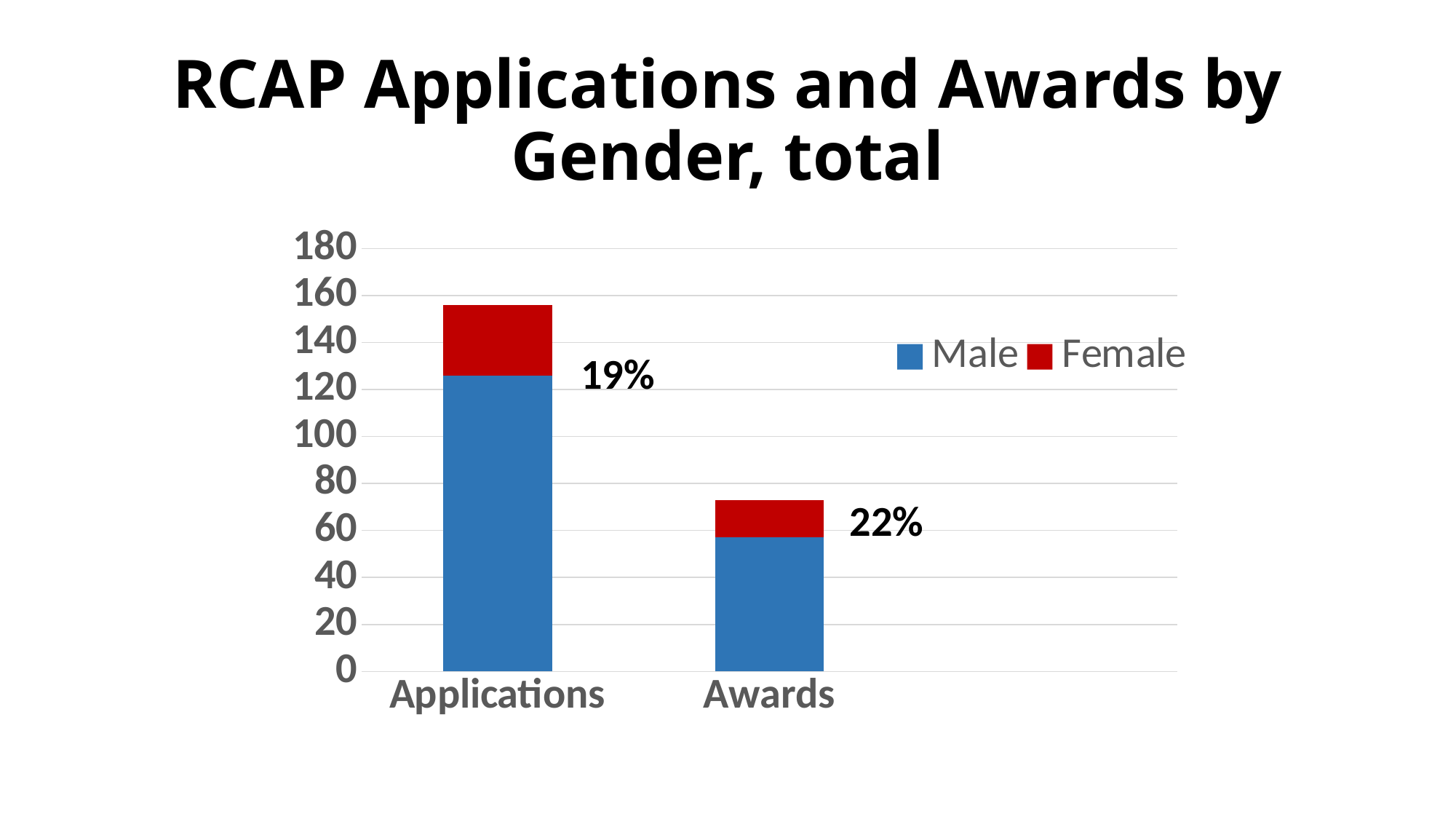
Which colour represents Female in the legend? Red How many series does the legend list? 2 Which category has the lowest total? Awards How many categories are shown on the x axis? 2 What percentage label is printed next to the Applications bar? 19% Is the Male value for Applications greater or less than 100? greater Is the total value for Applications greater or less than 140? greater Is the total value for Awards greater or less than 80? less Which category has the taller stacked bar, Applications or Awards? Applications What percentage label is printed next to the Awards bar? 22% What kind of chart is shown on the slide? Stacked bar chart